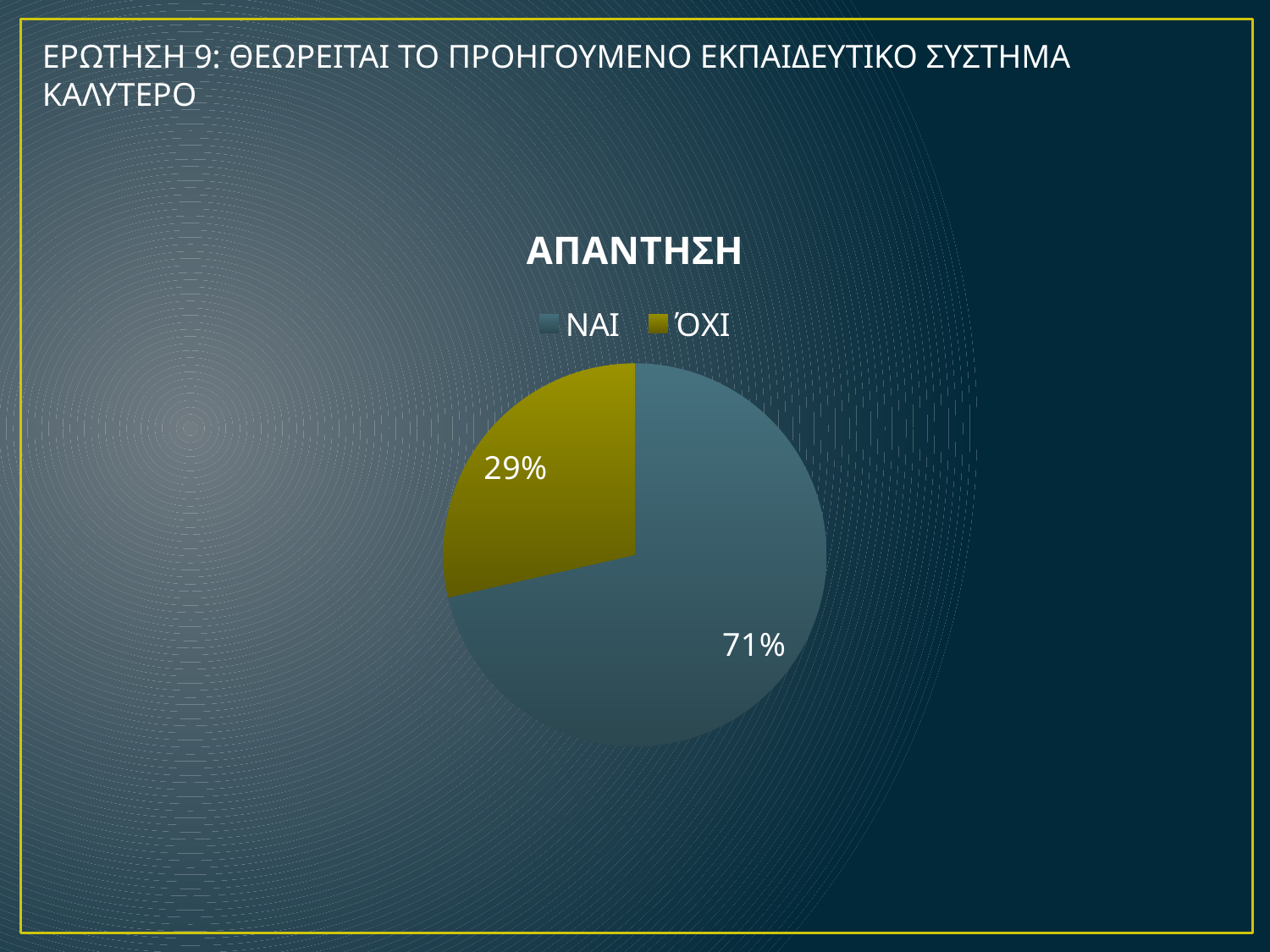
How many entries does the legend list? 2 What percentage of the pie chart is labelled ΌΧΙ? 29% What share of the pie does the ΝΑΙ slice represent? 71% What is the difference in percentage points between the ΝΑΙ and ΌΧΙ slices? 42 Which slice is larger, ΝΑΙ or ΌΧΙ? ΝΑΙ What kind of chart is shown on the slide? Pie chart What is the title of the chart? ΑΠΑΝΤΗΣΗ Which category has the largest share of the pie chart? ΝΑΙ How many slices does the pie chart have? 2 What colour is the ΌΧΙ slice of the pie chart? Yellow-olive Which category has the smallest share of the pie chart? ΌΧΙ What percentage of the pie chart is labelled ΝΑΙ? 71%